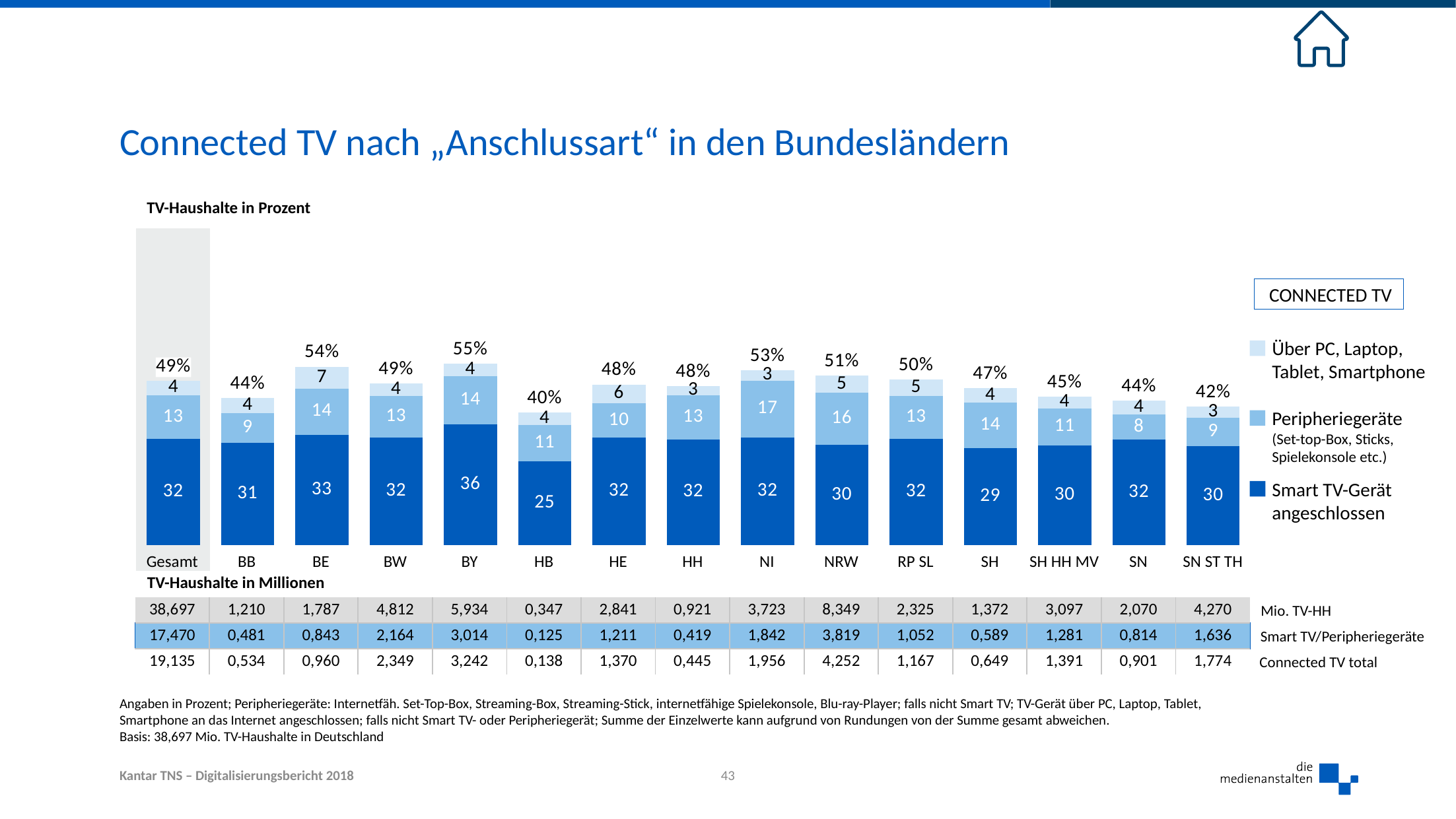
What is the difference in percentage points between the Connected TV total for BY and for HB? 15 What kind of chart is shown on the slide? Stacked bar chart What is the total Connected TV percentage shown for the Gesamt bar? 49% What is the value of the "Über PC, Laptop, Tablet, Smartphone" segment for BE? 7 What is the value of the "Smart TV-Gerät angeschlossen" segment for BY? 36 How many categories (bars) are shown on the x axis of the chart? 15 What is the value of the "Peripheriegeräte" segment for NI? 17 Which Bundesland has the lowest Connected TV percentage shown above its bar? HB What is the value of the "Peripheriegeräte" segment for Gesamt? 13 Which has a larger "Smart TV-Gerät angeschlossen" value, BE or SH? BE Which Bundesland has the highest Connected TV percentage shown above its bar? BY How many series does the chart legend list? 3